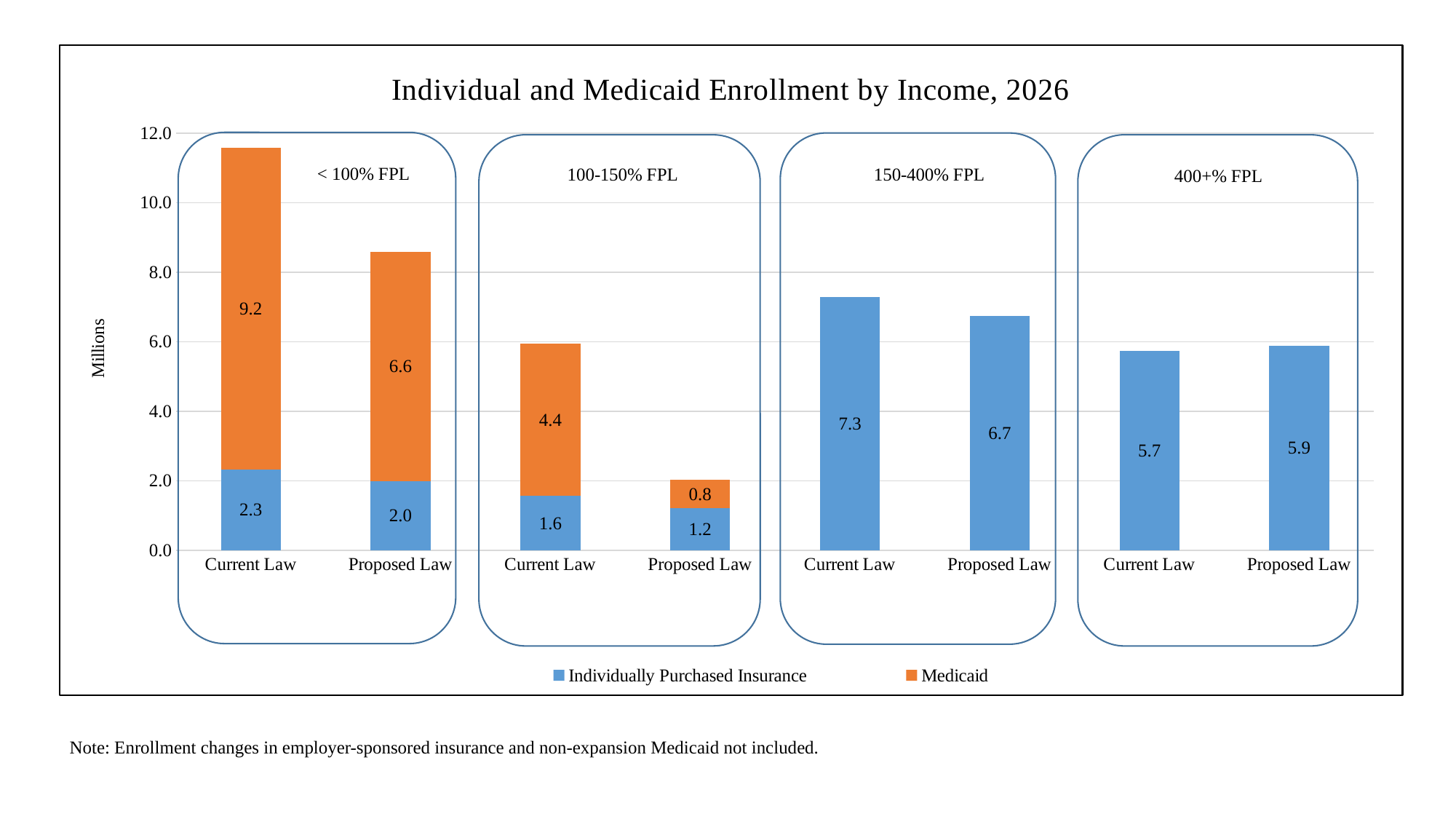
What is the total of the stacked bar for Current Law in the < 100% FPL group? 11.5 What is the title of the chart? Individual and Medicaid Enrollment by Income, 2026 What is the total of the stacked bar for Proposed Law in the 100-150% FPL group? 2.0 What is the Medicaid value for Current Law in the < 100% FPL group? 9.2 What is the Individually Purchased Insurance value for Current Law in the 150-400% FPL group? 7.3 Is the total for Current Law in the < 100% FPL group greater or less than 10.0? greater Which bar has the lowest Medicaid value among the bars that show Medicaid? Proposed Law in the 100-150% FPL group What is the difference between the Medicaid values for Current Law and Proposed Law in the < 100% FPL group? 2.6 How many series does the legend list? 2 What kind of chart is shown on the slide? Stacked bar chart What is the Individually Purchased Insurance value for Proposed Law in the 100-150% FPL group? 1.2 Which is larger: the Individually Purchased Insurance value for Current Law or for Proposed Law in the 400+% FPL group? Proposed Law